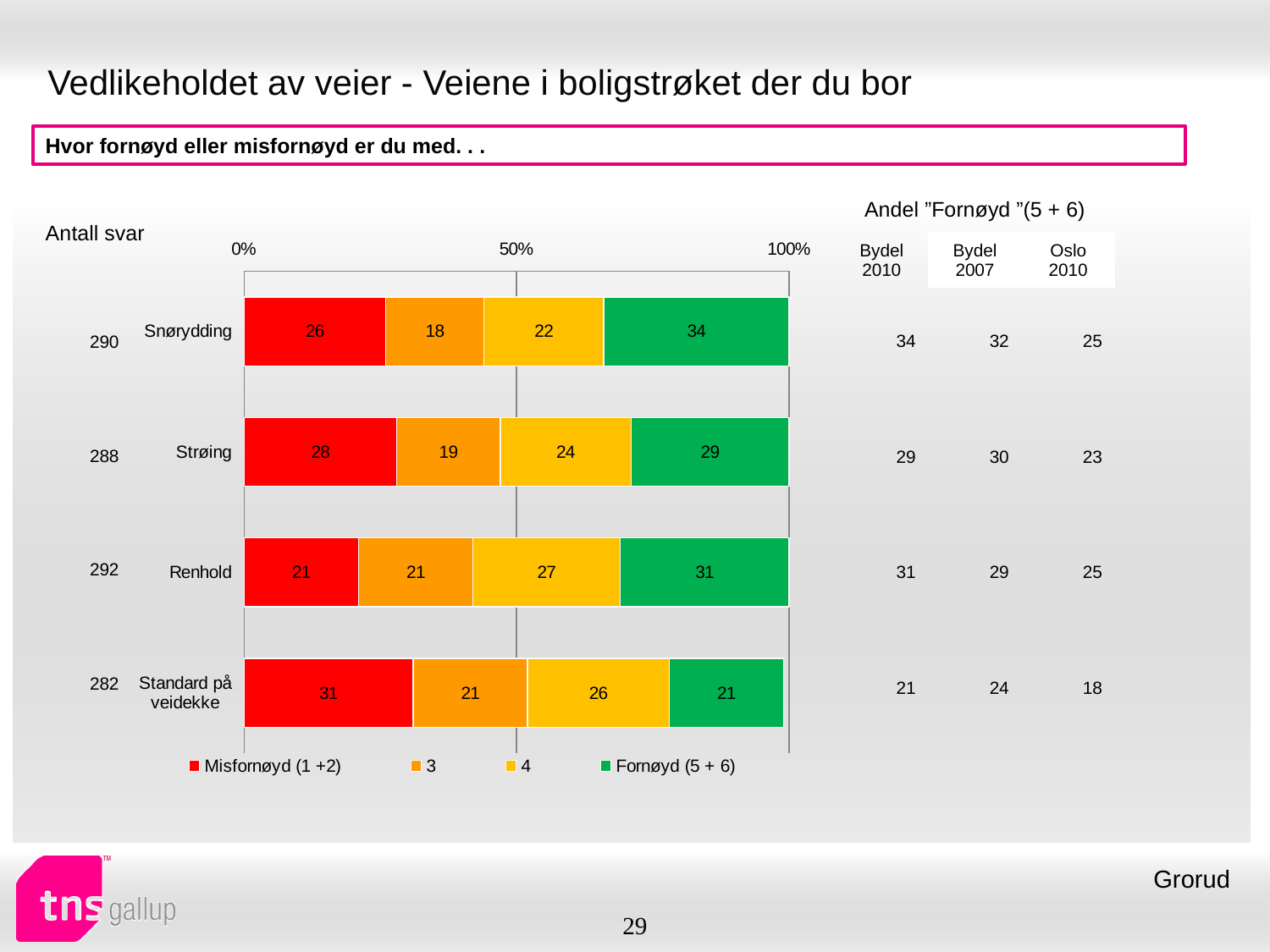
What is the difference between the Misfornøyd (1 +2) values for Standard på veidekke and Renhold? 10 What is the total of the stacked bar for Snørydding? 100 What is the value of series 4 for Renhold? 27 How many series does the legend list? 4 What kind of chart is shown on the slide? stacked bar chart Which category has the highest Fornøyd (5 + 6) value? Snørydding How many categories are plotted in the chart? 4 Which is larger: the Fornøyd (5 + 6) value for Strøing or for Renhold? Renhold What is the Fornøyd (5 + 6) value for Snørydding? 34 Which category has the lowest Fornøyd (5 + 6) value? Standard på veidekke What is the value of series 3 for Strøing? 19 What is the Misfornøyd (1 +2) value for Standard på veidekke? 31